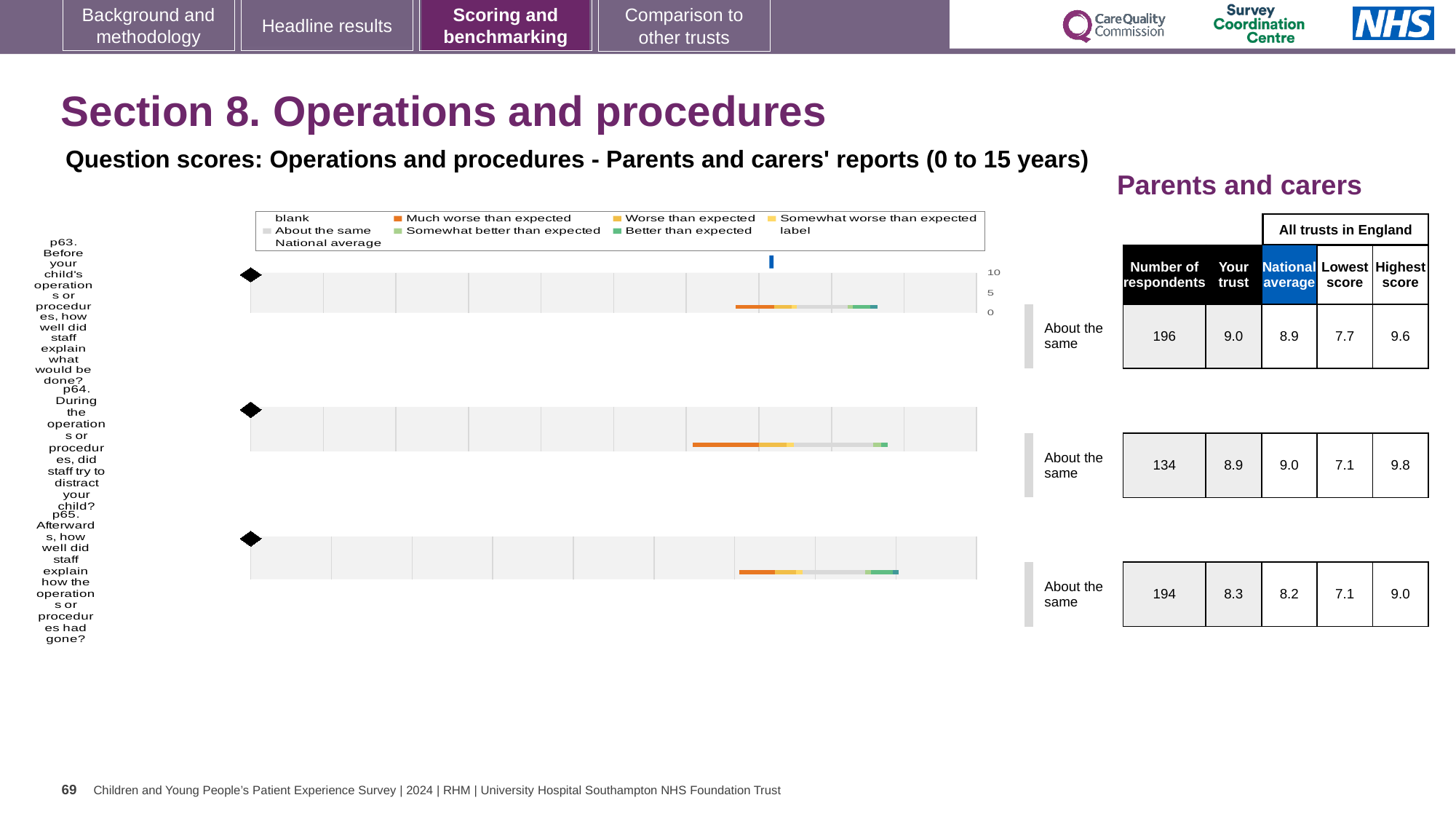
What kind of chart is used to show the benchmarking for each question? Bar chart What is the 'Your trust' score for p63 (how well staff explained what would be done before the operation)? 9.0 What benchmark category is shown for p64? About the same How many respondents answered p65 (how well staff explained how the operation had gone)? 194 How many survey questions (p63, p64, p65) have benchmarking bars on this slide? 3 For p65, which is larger: the 'Your trust' score or the national average? Your trust What is the national average score for p64 (did staff try to distract your child during the operation)? 9.0 For p64, what is the difference between the highest score and the lowest score across all trusts in England? 2.7 Which question has the lowest 'Your trust' score? p65 What colour represents 'Much worse than expected' in the legend? Orange Which question has the highest 'Your trust' score? p63 What is the highest score across all trusts in England for p63? 9.6